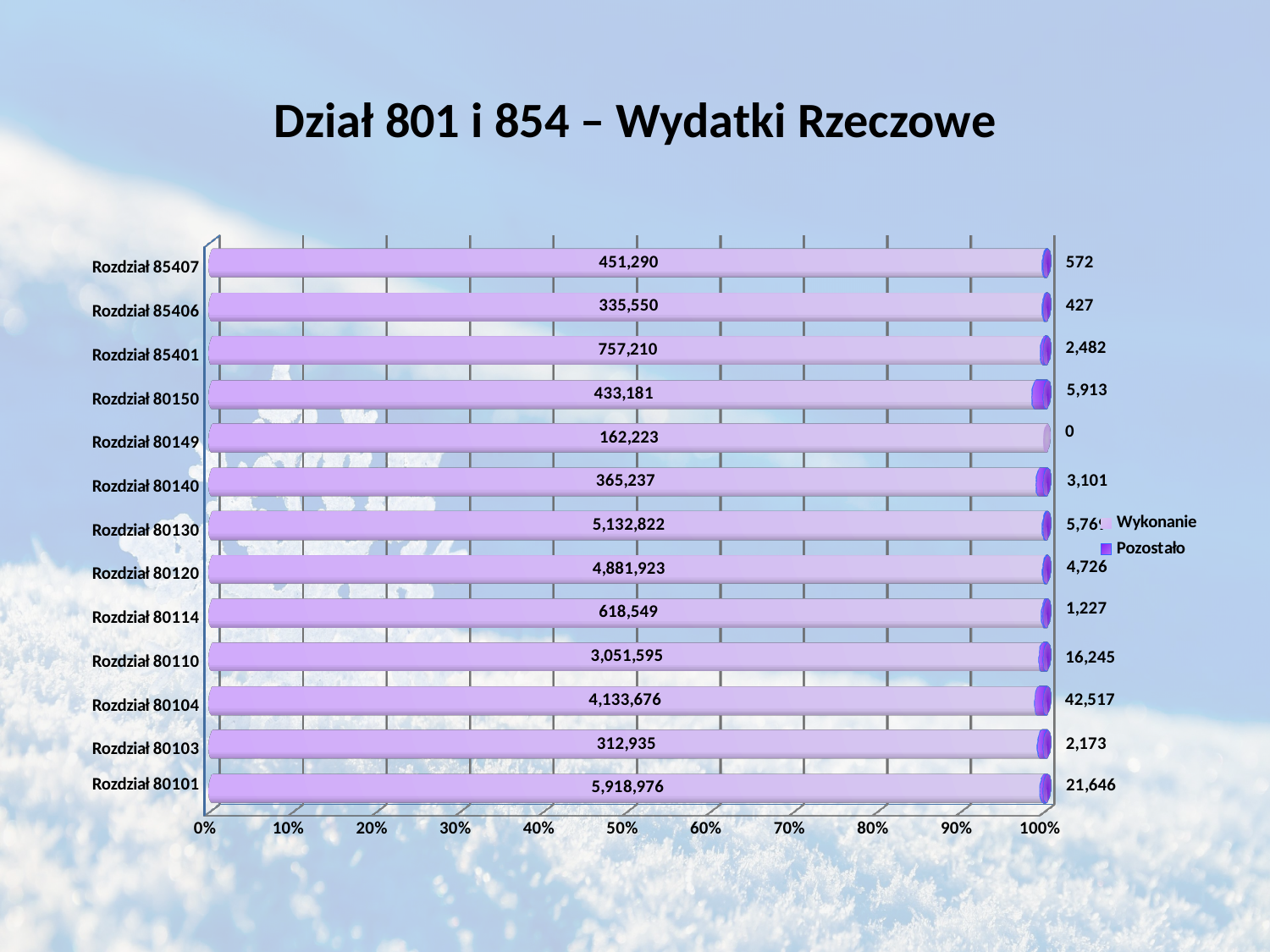
How many categories (Rozdział entries) are shown on the chart? 13 Which category has the lowest Wykonanie value? Rozdział 80149 What is the difference between the Wykonanie values for Rozdział 80101 and Rozdział 80130? 786,154 What kind of chart is shown on the slide? Stacked bar chart Which category has the highest Pozostało value? Rozdział 80104 Which category has the highest Wykonanie value? Rozdział 80101 What is the Wykonanie value for Rozdział 80101? 5,918,976 Which has a larger Wykonanie value, Rozdział 80120 or Rozdział 80110? Rozdział 80120 How many series does the legend list? 2 What is the Pozostało value for Rozdział 80149? 0 What is the Wykonanie value for Rozdział 85401? 757,210 What is the Pozostało value for Rozdział 80104? 42,517